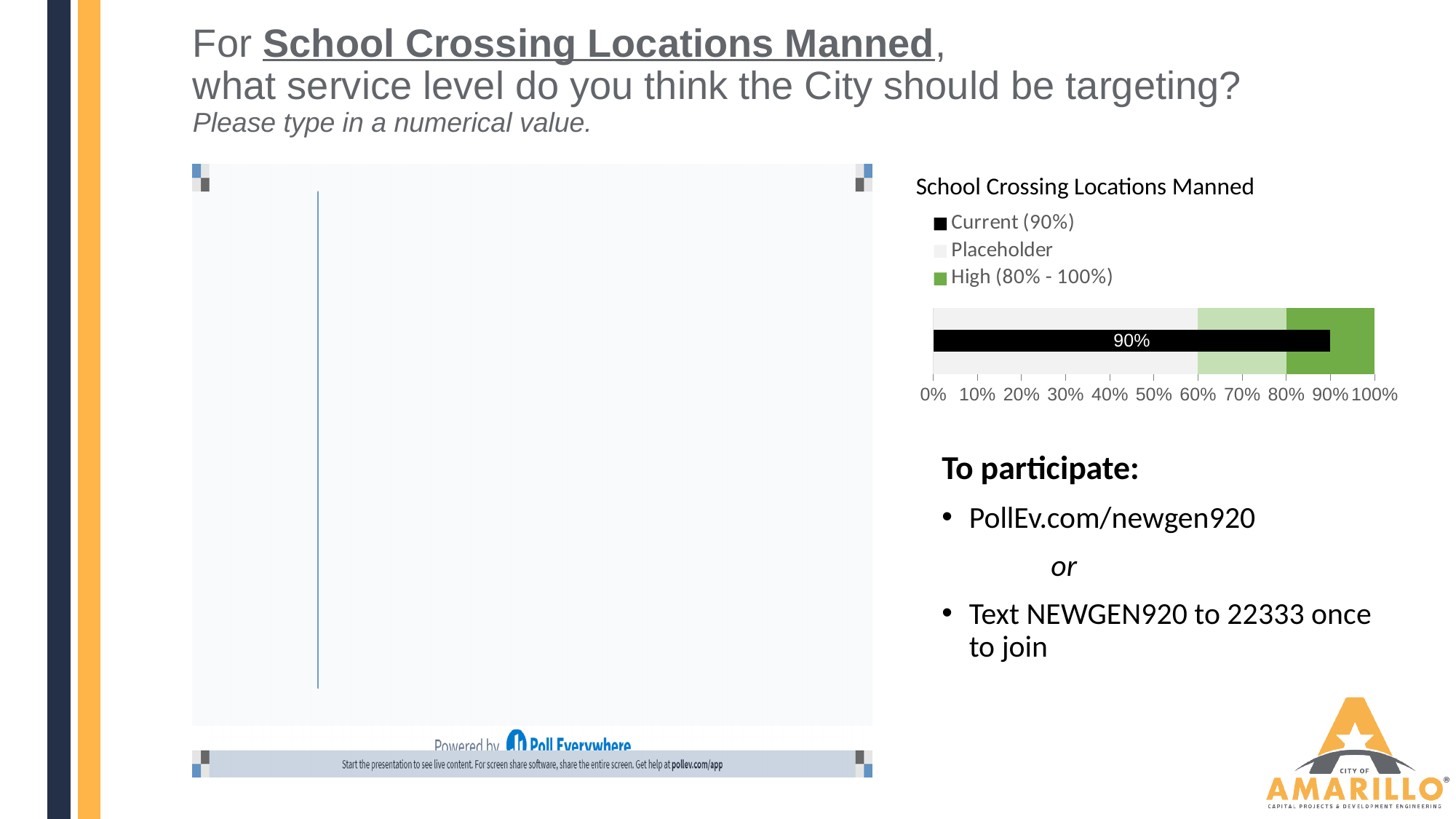
In the School Crossing Locations Manned chart, what value is printed on the black Current bar? 90% In the School Crossing Locations Manned chart, is the Current value greater or less than 80%? greater In the School Crossing Locations Manned chart, what is the highest value shown on the horizontal axis? 100% How many entries does the legend of the School Crossing Locations Manned chart list? 3 What is the title of the chart on the right side of the slide? School Crossing Locations Manned In the School Crossing Locations Manned chart, is the Current value greater or less than 100%? less What kind of chart is the School Crossing Locations Manned chart? bar chart In the School Crossing Locations Manned chart, what range does the legend give for the High series? 80% - 100% In the School Crossing Locations Manned chart, is the Current value greater or less than 50%? greater In the School Crossing Locations Manned chart, what is the lowest value shown on the horizontal axis? 0%